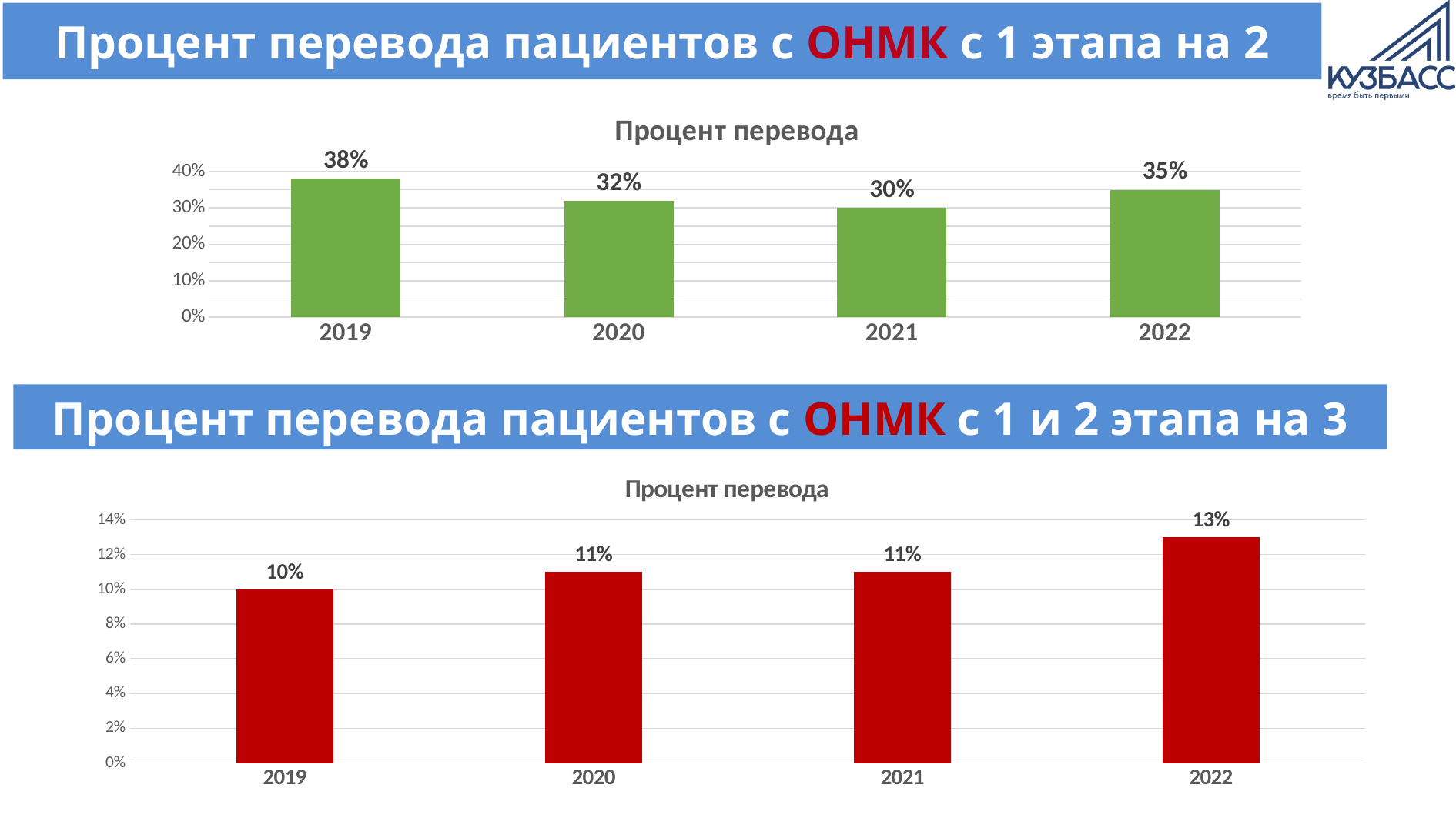
In the top chart (transfer from stage 1 to 2), which year has the lowest value? 2021 In the top chart (transfer from stage 1 to 2), what is the value for 2019? 38% In the top chart (transfer from stage 1 to 2), which year has the highest value? 2019 In the bottom chart (transfer from stages 1 and 2 to 3), what is the value for 2022? 13% In the top chart (transfer from stage 1 to 2), what is the value for 2021? 30% In the top chart (transfer from stage 1 to 2), which is larger, the value for 2020 or the value for 2022? 2022 In the top chart (transfer from stage 1 to 2), what is the difference between the values for 2019 and 2022? 3% What kind of chart is the top chart (transfer from stage 1 to 2)? Bar chart In the bottom chart (transfer from stages 1 and 2 to 3), what is the value for 2019? 10% How many years are shown on the x axis of the bottom chart (transfer from stages 1 and 2 to 3)? 4 In the bottom chart (transfer from stages 1 and 2 to 3), what is the difference between the values for 2022 and 2019? 3% In the bottom chart (transfer from stages 1 and 2 to 3), which year has the highest value? 2022